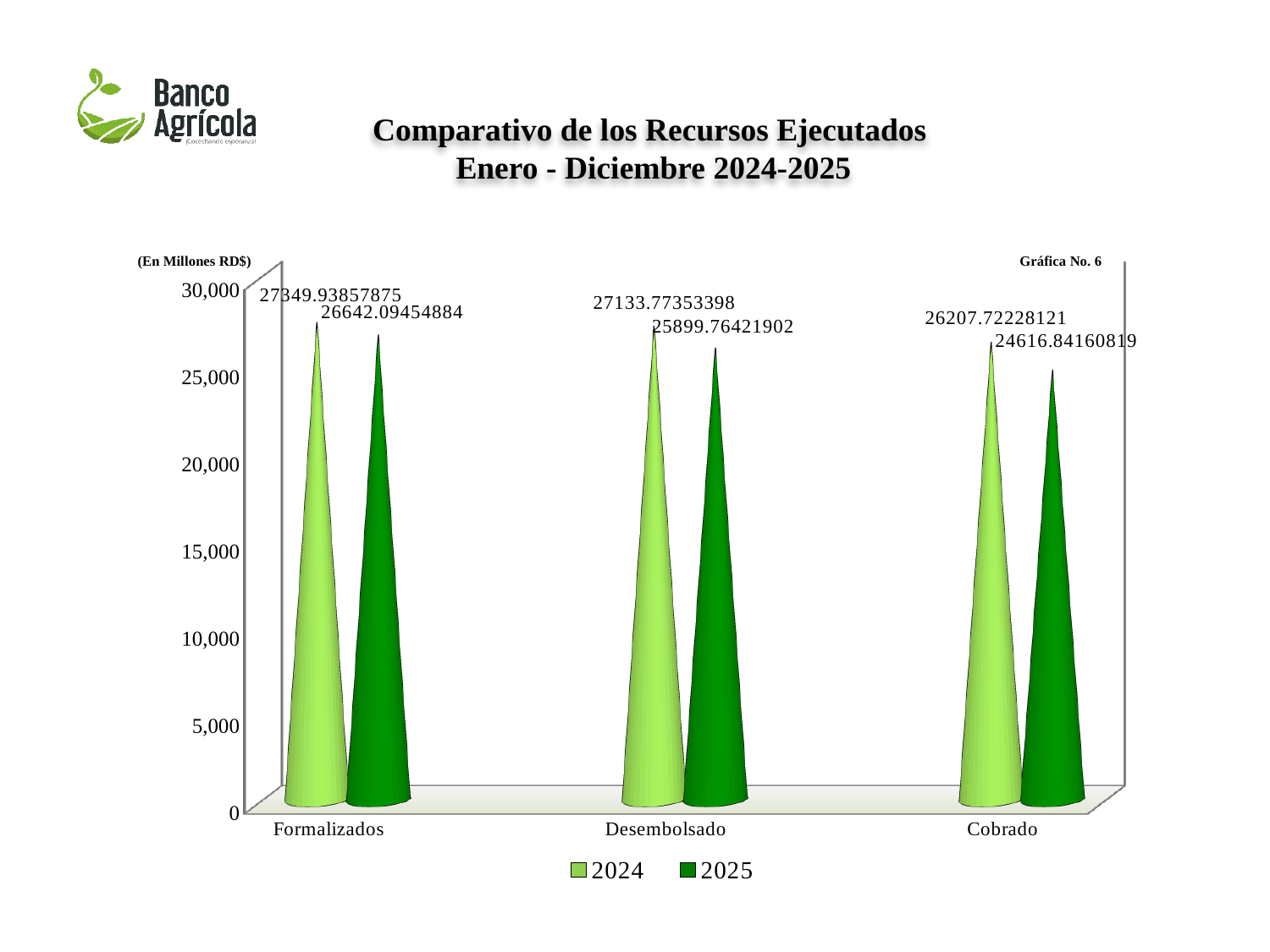
Do the 2025 values rise or fall from Formalizados to Cobrado? fall How many series does the legend list? 2 What is the value for Formalizados in the 2024 series? 27349.93857875 What is the difference between the 2024 and 2025 values for Cobrado? 1590.88067302 Which category has the highest value in the 2024 series? Formalizados What is the value for Cobrado in the 2025 series? 24616.84160819 How many categories are shown on the x axis? 3 Which is larger for Desembolsado, the 2024 value or the 2025 value? 2024 What unit is stated in the top-left corner of the chart? En Millones RD$ What is the value for Desembolsado in the 2025 series? 25899.76421902 What is the value for Cobrado in the 2024 series? 26207.72228121 Which category has the lowest value in the 2025 series? Cobrado